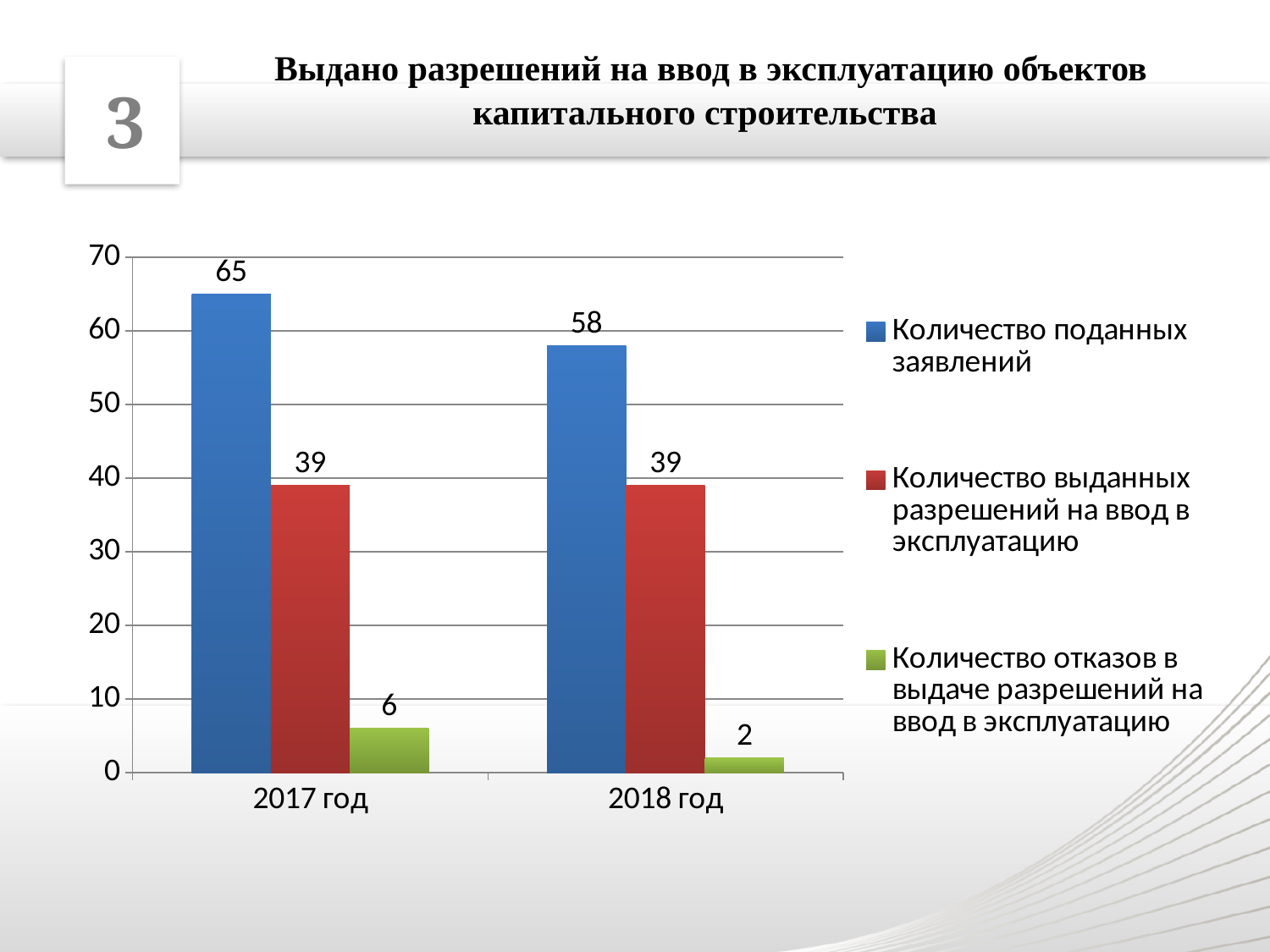
Is 'Количество поданных заявлений' for 2018 год greater or less than 60? less Does 'Количество поданных заявлений' rise or fall from 2017 год to 2018 год? Fall What is the value of 'Количество выданных разрешений на ввод в эксплуатацию' for 2018 год? 39 What is the difference between 'Количество отказов в выдаче разрешений на ввод в эксплуатацию' in 2017 год and 2018 год? 4 What is the difference between 'Количество поданных заявлений' in 2017 год and 2018 год? 7 What is the value of 'Количество поданных заявлений' for 2017 год? 65 What is the value of 'Количество поданных заявлений' for 2018 год? 58 What is the value of 'Количество отказов в выдаче разрешений на ввод в эксплуатацию' for 2017 год? 6 Which year has the higher value for 'Количество поданных заявлений'? 2017 год What kind of chart is shown on the slide? Bar chart Which year has the lower value for 'Количество отказов в выдаче разрешений на ввод в эксплуатацию'? 2018 год How many series does the legend list? 3